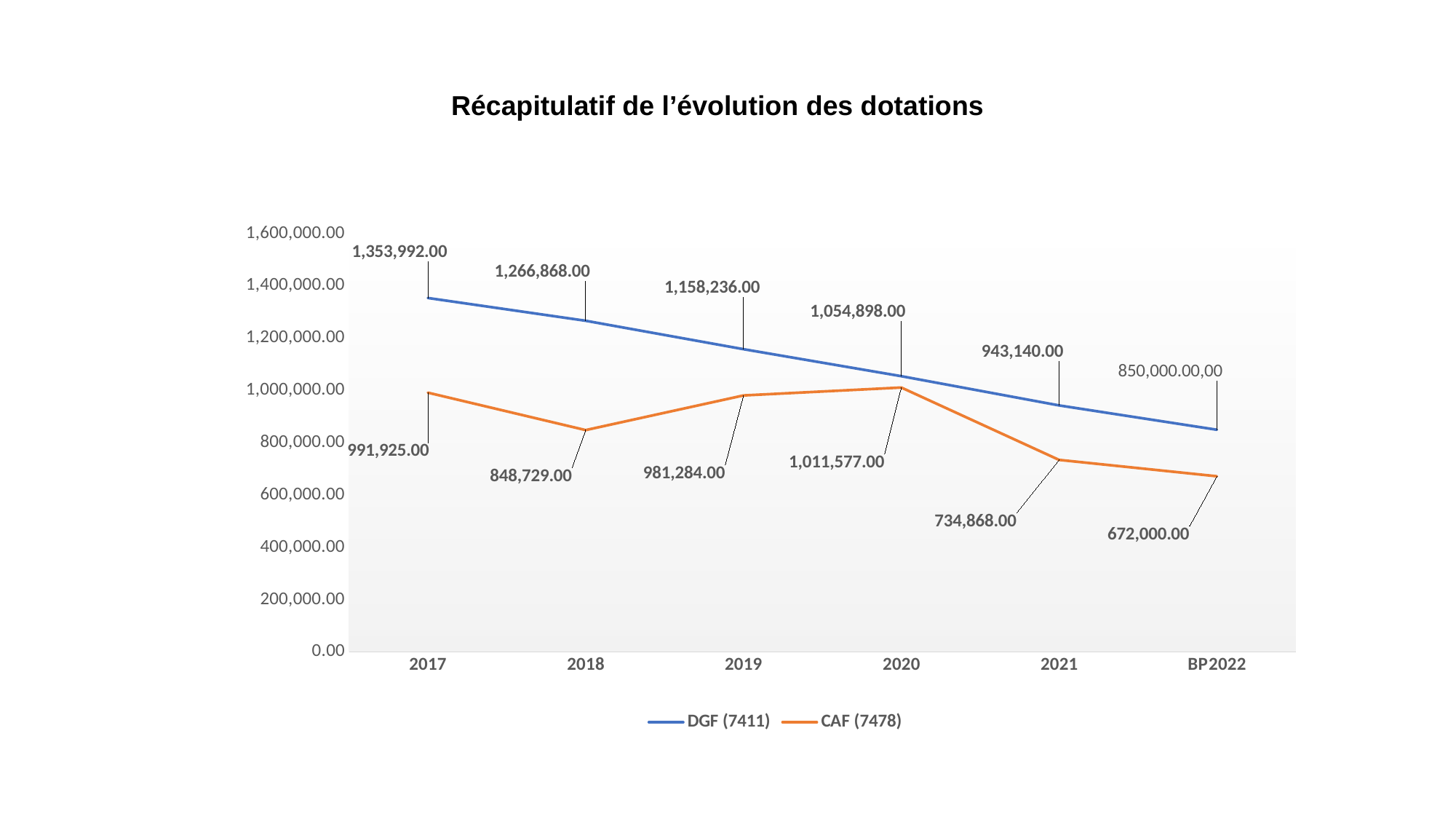
How many series does the legend list? 2 What is the value of DGF (7411) in 2021? 943,140.00 What is the difference between DGF (7411) in 2017 and in 2018? 87,124.00 What kind of chart is this? Line chart What is the value of CAF (7478) in 2018? 848,729.00 How many years are shown on the x axis? 6 Does DGF (7411) rise or fall from 2017 to BP2022? Fall In which year does CAF (7478) reach its highest value? 2020 What is the value of DGF (7411) in 2017? 1,353,992.00 In which year is DGF (7411) at its lowest? BP2022 What is the value of CAF (7478) for BP2022? 672,000.00 Which is larger in 2019: DGF (7411) or CAF (7478)? DGF (7411)